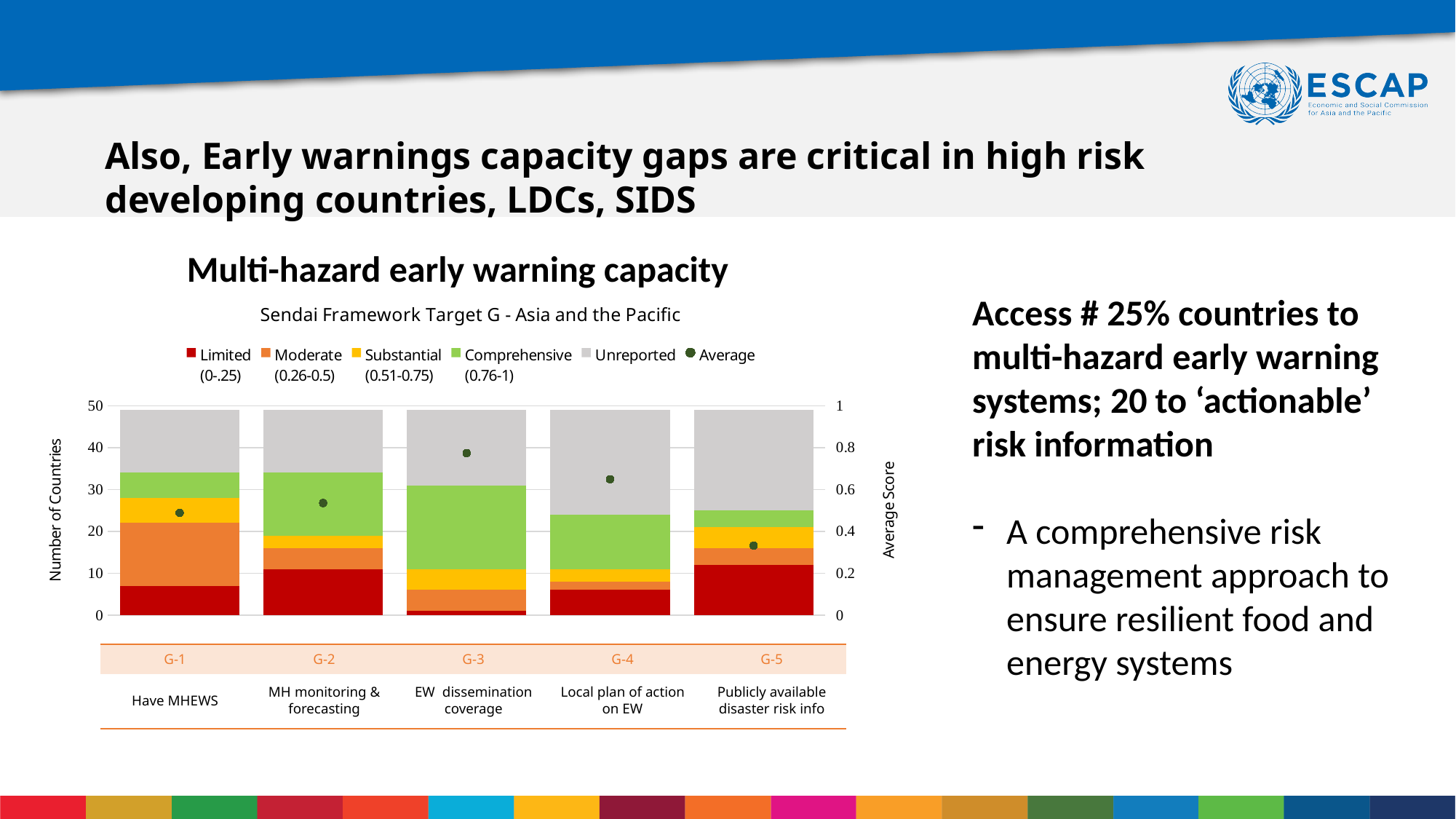
How many categories (G-1 to G-5) are plotted on the x axis of the chart? 5 What kind of chart is shown under the title "Multi-hazard early warning capacity"? Stacked bar chart Which category has the lowest Average score marker? G-5 (Publicly available disaster risk info) Which category has the largest Comprehensive (0.76-1) segment? G-3 (EW dissemination coverage) Is the Average score for G-5 greater or less than 0.4? less Which category has the smallest Limited (0-.25) segment? G-3 (EW dissemination coverage) How many entries does the chart's legend list? 6 What is the label of the right-hand vertical axis of the chart? Average Score Which category has the highest Average score marker? G-3 (EW dissemination coverage) Which has the higher Average score, G-4 or G-5? G-4 Is the Average score for G-3 greater or less than 0.6? greater Which category has the largest Moderate (0.26-0.5) segment? G-1 (Have MHEWS)